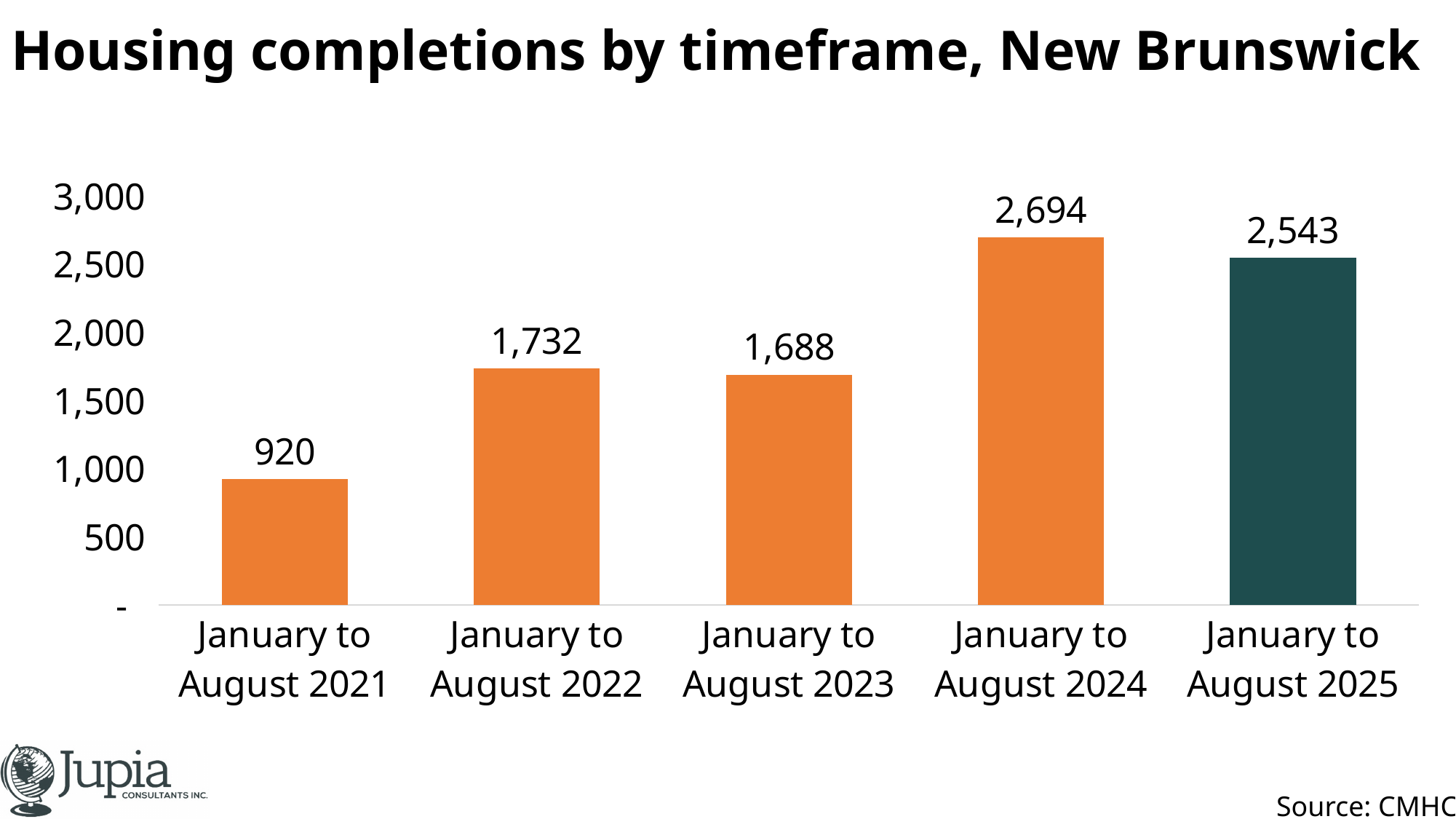
What is the value for January to August 2021? 920 What is the difference between the values for January to August 2022 and January to August 2021? 812 Which timeframe has the highest number of housing completions? January to August 2024 Which is larger, the value for January to August 2022 or January to August 2023? January to August 2022 What is the title of the chart? Housing completions by timeframe, New Brunswick How many timeframes are shown on the chart? 5 Which timeframe has the lowest number of housing completions? January to August 2021 Is the value for January to August 2023 greater or less than 2,000? less What kind of chart is shown on the slide? bar chart What is the value for January to August 2024? 2,694 What is the value for January to August 2025? 2,543 What is the difference between the values for January to August 2024 and January to August 2025? 151